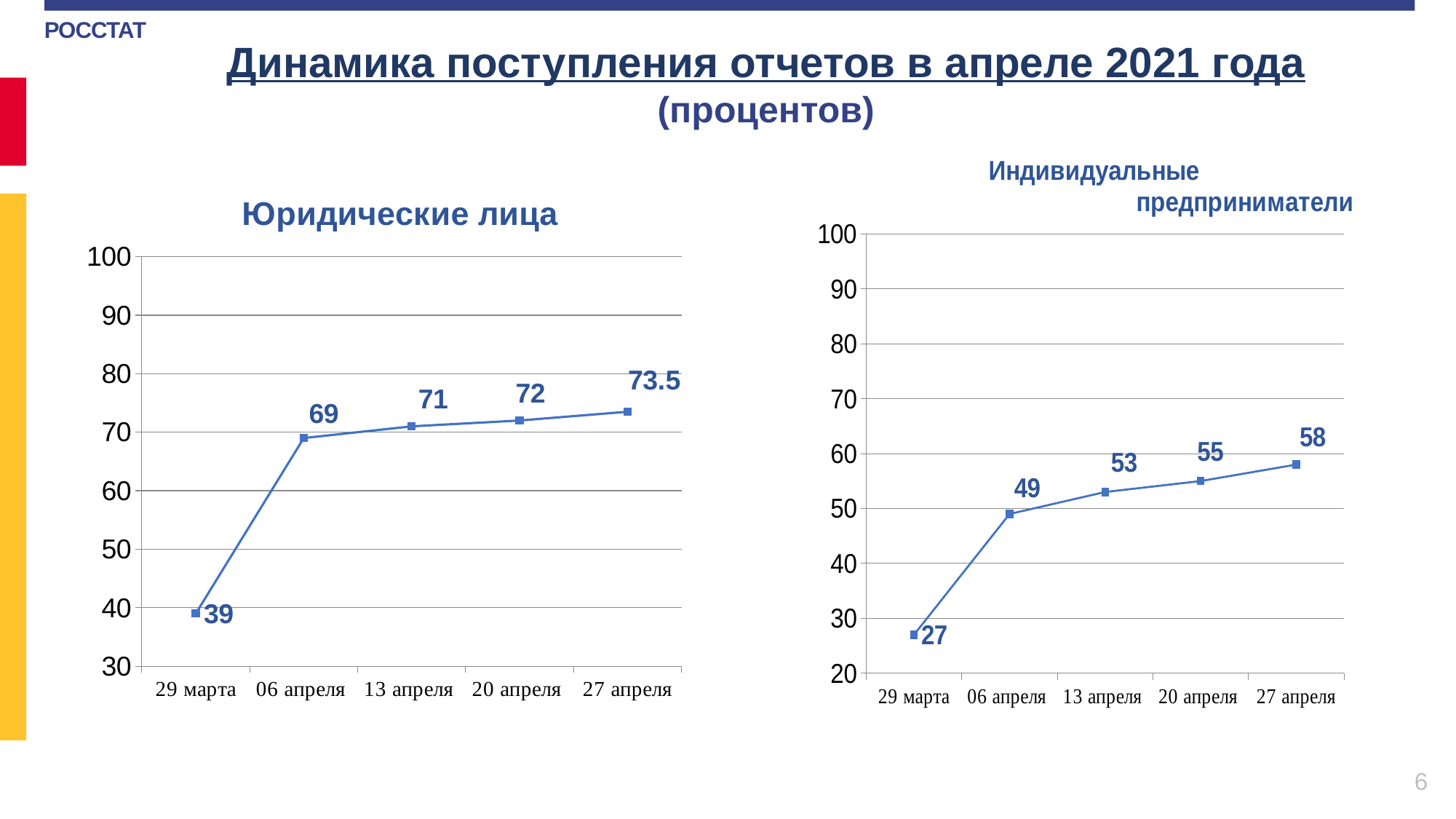
In the 'Юридические лица' chart, what is the value for 29 марта? 39 What kind of chart is the 'Юридические лица' chart? Line chart In the 'Юридические лица' chart, what is the value for 06 апреля? 69 In the 'Юридические лица' chart, what is the difference between the values for 06 апреля and 29 марта? 30 In the 'Индивидуальные предприниматели' chart, which date has the lowest value? 29 марта In the 'Индивидуальные предприниматели' chart, do the values rise or fall from 29 марта to 27 апреля? Rise In the 'Индивидуальные предприниматели' chart, what is the difference between the values for 27 апреля and 20 апреля? 3 In the 'Индивидуальные предприниматели' chart, what is the value for 27 апреля? 58 How many data points are plotted in the 'Индивидуальные предприниматели' chart? 5 Which is larger: the value for 20 апреля in the 'Юридические лица' chart or the value for 20 апреля in the 'Индивидуальные предприниматели' chart? Юридические лица In the 'Индивидуальные предприниматели' chart, what is the value for 13 апреля? 53 In the 'Юридические лица' chart, which date has the highest value? 27 апреля